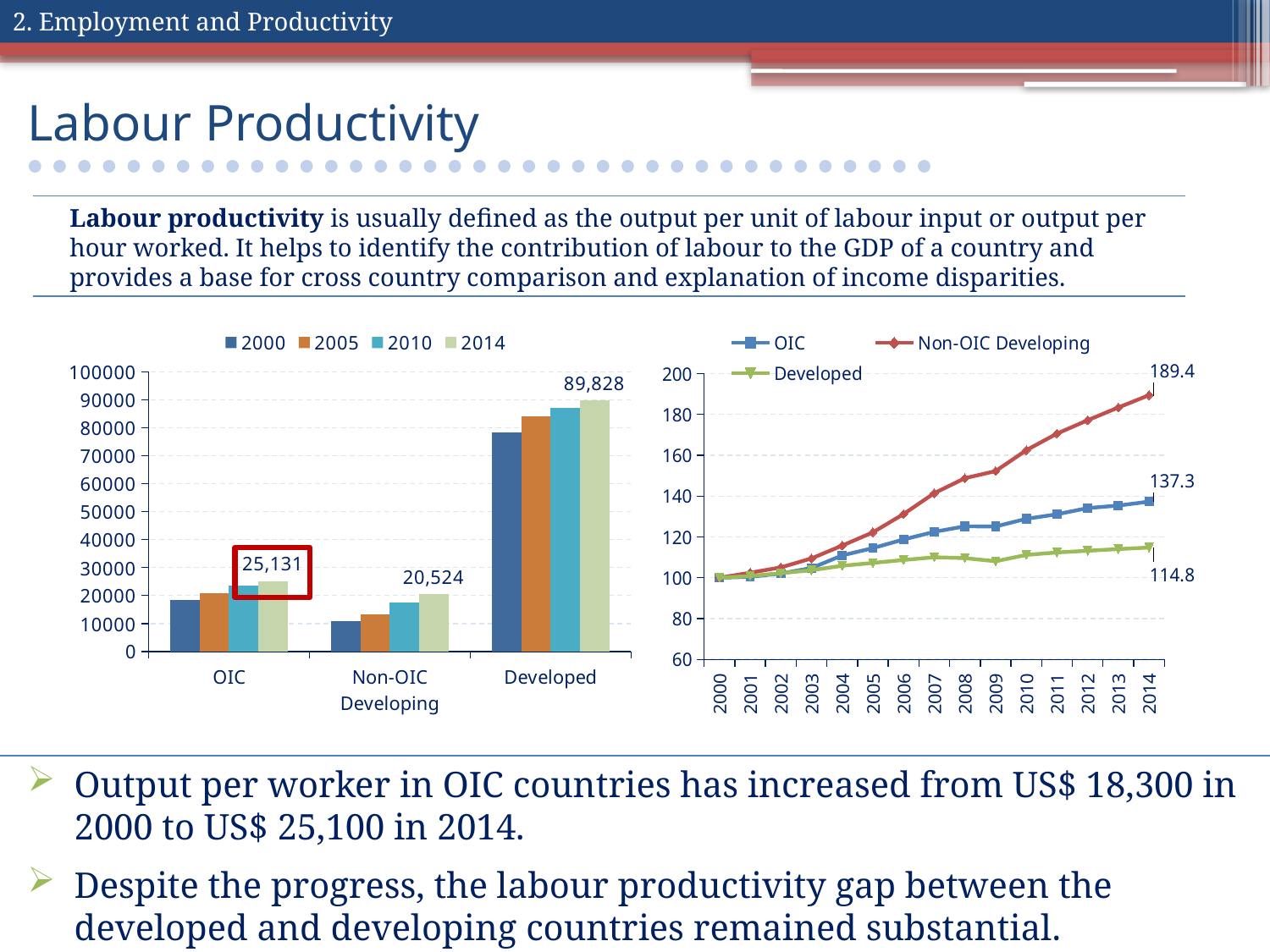
In the bar chart on the left, what is the value for Developed in 2014? 89,828 In the bar chart on the left, is the value for OIC in 2000 greater or less than 20000? less In the bar chart on the left, which category has the highest values? Developed In the line chart on the right, which series has the lowest value in 2014? Developed In the line chart on the right, what is the value for Developed in 2014? 114.8 In the line chart on the right, what is the value for Non-OIC Developing in 2014? 189.4 In the bar chart on the left, how many series does the legend list? 4 In the bar chart on the left, what is the difference between the 2014 values for OIC and Non-OIC Developing? 4,607 In the line chart on the right, what is the difference between the 2014 values for Non-OIC Developing and OIC? 52.1 In the bar chart on the left, what is the value for OIC in 2014? 25,131 In the bar chart on the left, what is the value for Non-OIC Developing in 2014? 20,524 What kind of chart is shown on the right side of the slide? Line chart